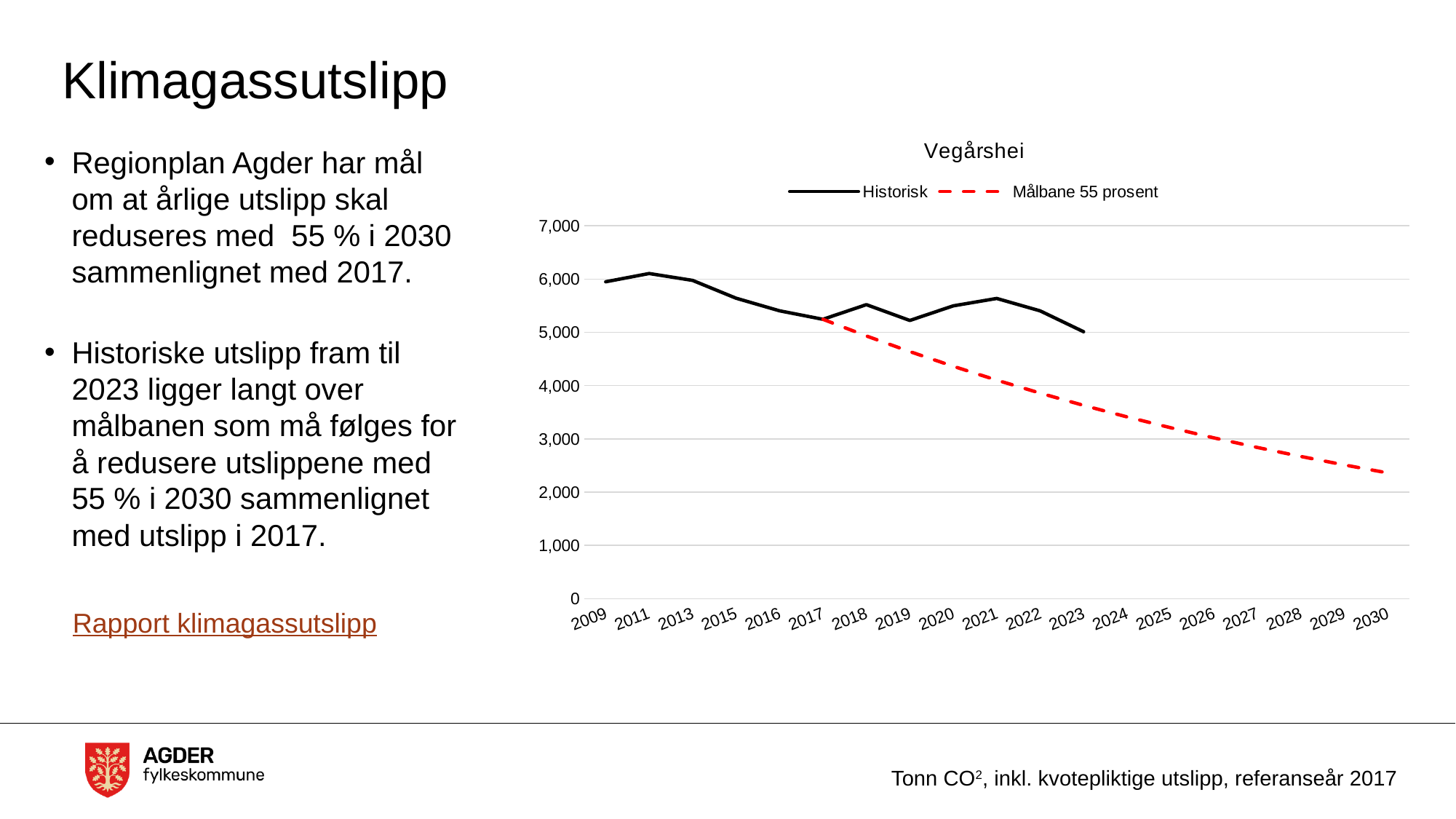
How many series does the chart legend list? 2 In which year does the Målbane 55 prosent series reach its lowest value? 2030 Does the Målbane 55 prosent line rise or fall from 2017 to 2030? Fall Is the Historisk value for 2021 greater or less than 6,000? less What are the two series named in the chart legend? Historisk and Målbane 55 prosent In 2021, which series has the larger value, Historisk or Målbane 55 prosent? Historisk What is the title of the chart? Vegårshei Is the Målbane 55 prosent value for 2024 greater or less than 4,000? less What kind of chart is shown on the slide? Line chart Is the Målbane 55 prosent value for 2030 greater or less than 3,000? less How many year labels are shown on the x axis of the chart? 19